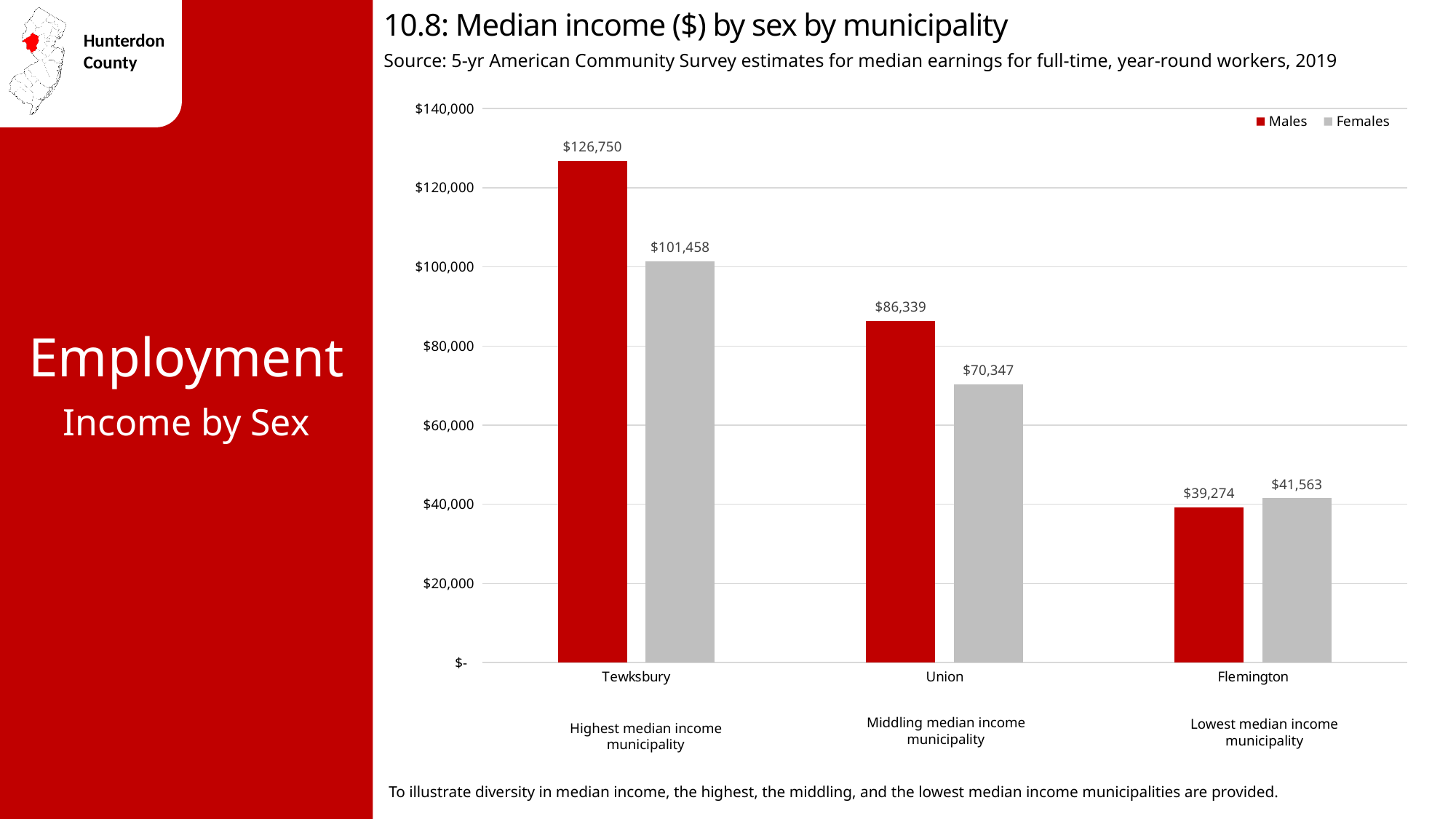
What is the difference between male and female median income in Union? $15,992 Which municipality has the lowest median income for females? Flemington What is the difference between male and female median income in Tewksbury? $25,292 What is the median income for females in Union? $70,347 How many municipalities are shown on the chart? 3 Is the median income for males in Union greater or less than $80,000? greater Which municipality has the highest median income for males? Tewksbury How many series does the legend list? 2 What is the median income for females in Flemington? $41,563 What type of chart is shown on the slide? Bar chart In Flemington, is the median income higher for males or females? Females What is the median income for males in Tewksbury? $126,750